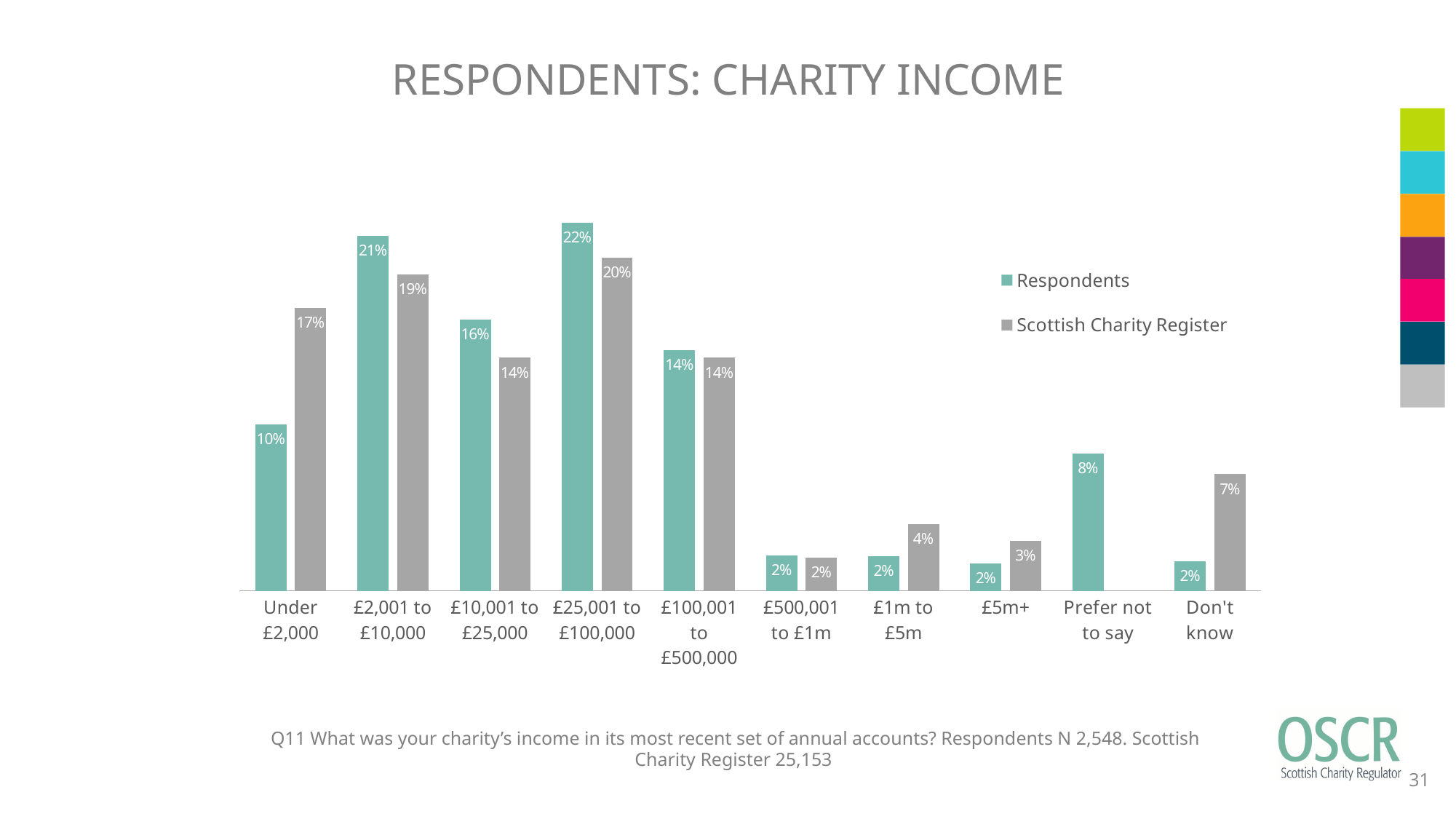
What is the difference between the Respondents and Scottish Charity Register values for 'Don't know'? 5% What percentage of Respondents answered 'Prefer not to say'? 8% Which income category has the highest value for the Scottish Charity Register? £25,001 to £100,000 What is the difference between the Scottish Charity Register and Respondents values for Under £2,000? 7% What type of chart is shown on the slide? Bar chart What percentage of Respondents had an income of £25,001 to £100,000? 22% How many income categories are shown on the x axis? 10 For the £1m to £5m category, which series has the larger value, Respondents or Scottish Charity Register? Scottish Charity Register What is the Scottish Charity Register value for the Under £2,000 category? 17% How many series does the legend list? 2 For the £10,001 to £25,000 category, which series has the larger value, Respondents or Scottish Charity Register? Respondents Which income category has the highest value for Respondents? £25,001 to £100,000